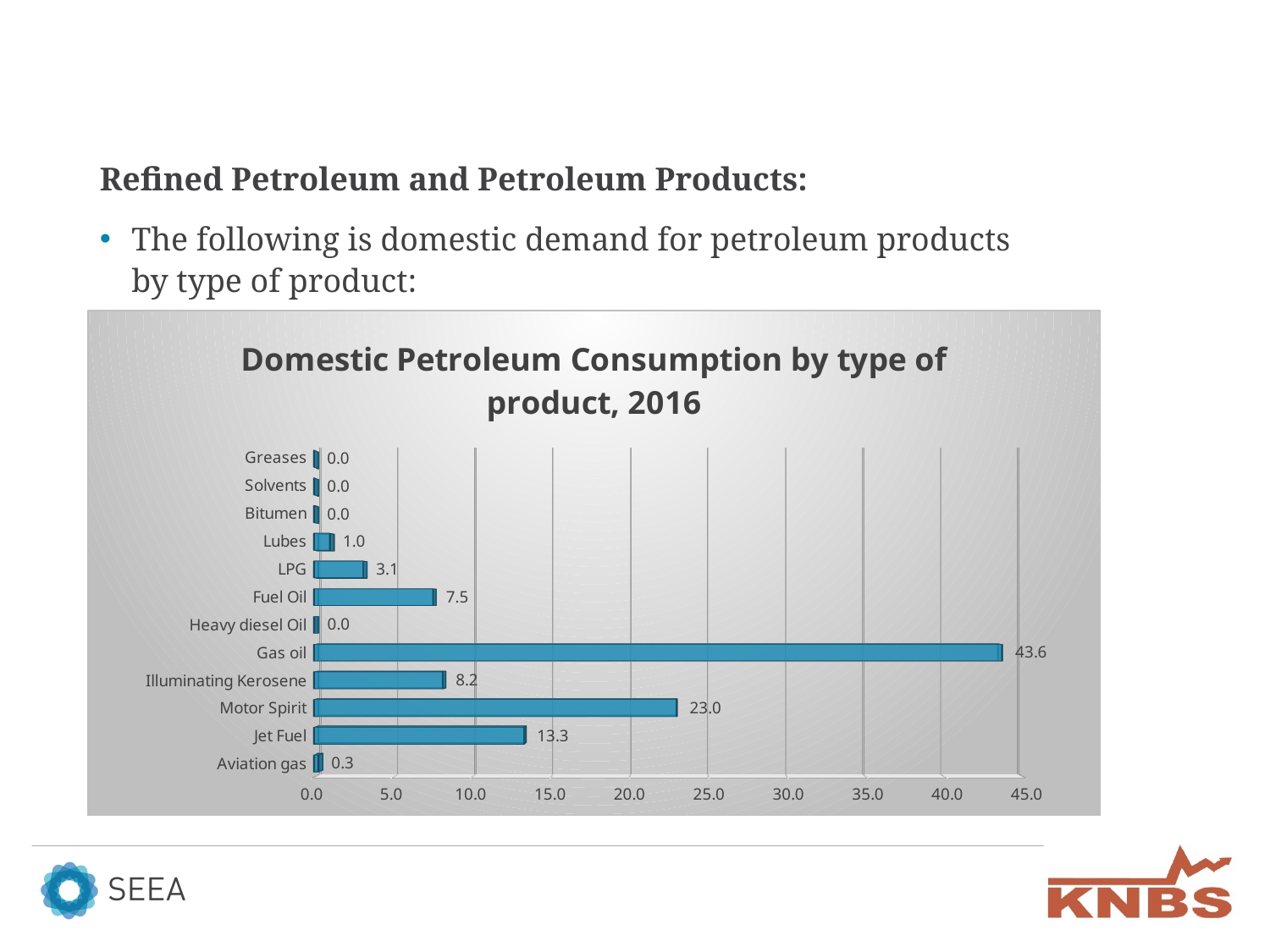
How many product categories are shown on the chart? 12 What is the value for Jet Fuel? 13.3 What is the difference between the values for Jet Fuel and Fuel Oil? 5.8 Which product has the highest value? Gas oil What is the difference between the values for Gas oil and Motor Spirit? 20.6 What kind of chart is shown on the slide? Bar chart What is the value for Gas oil? 43.6 What is the value for Motor Spirit? 23.0 Which is larger, the value for Illuminating Kerosene or the value for Fuel Oil? Illuminating Kerosene What is the title of the chart? Domestic Petroleum Consumption by type of product, 2016 What is the value for LPG? 3.1 What is the value for Illuminating Kerosene? 8.2